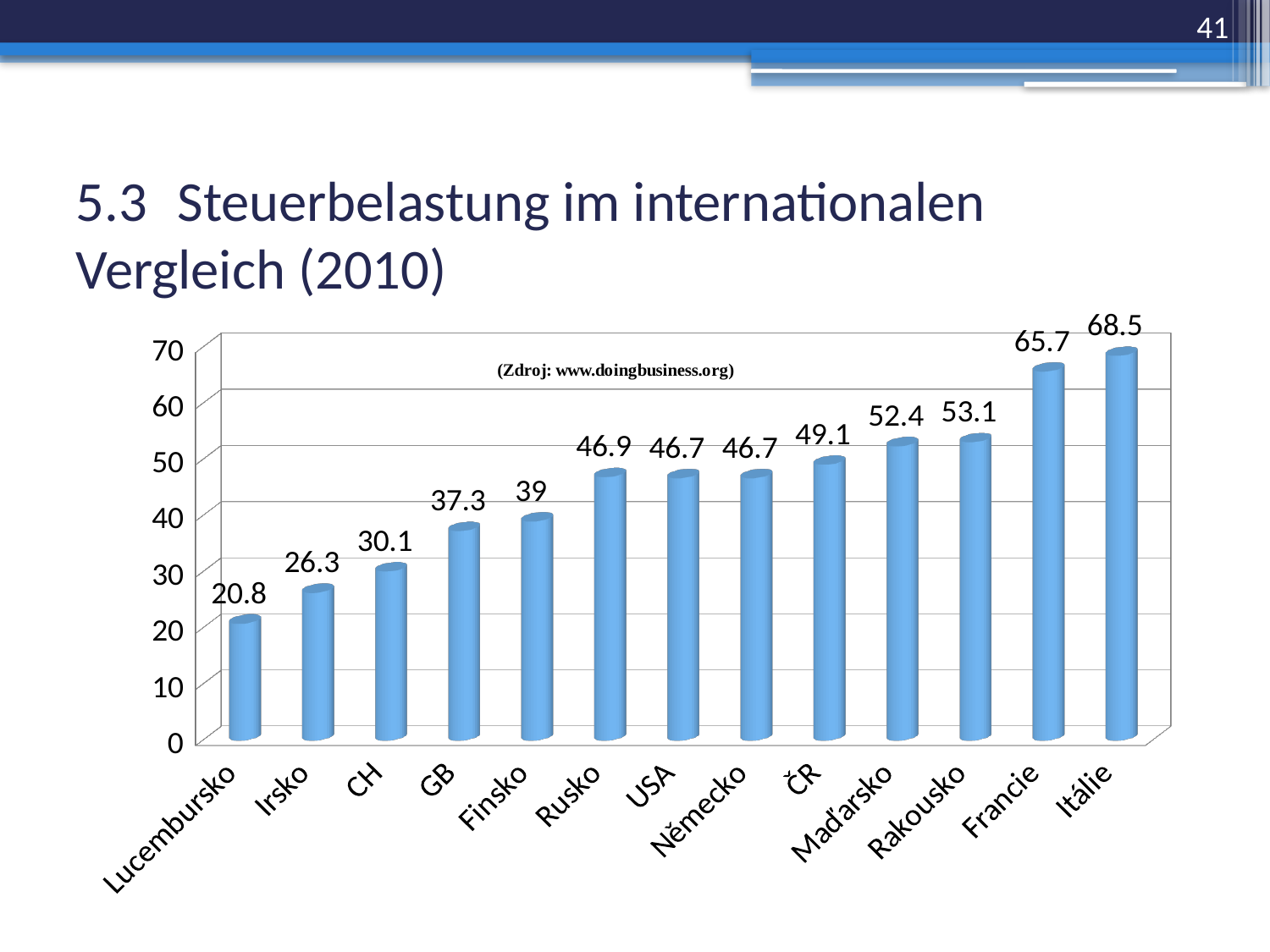
Which country has the highest value? Itálie What is the value for Maďarsko? 52.4 Which country has the lowest value? Lucembursko Which is larger, the value for Rakousko or the value for ČR? Rakousko What is the difference between the values for Itálie and Francie? 2.8 What is the value for Finsko? 39 What kind of chart is shown on the slide? bar chart What is the value for Lucembursko? 20.8 What is the difference between the values for GB and Irsko? 11 Is the value for Rusko greater or less than 40? greater Do the values rise or fall from left to right along the x axis? rise How many countries are shown on the chart? 13